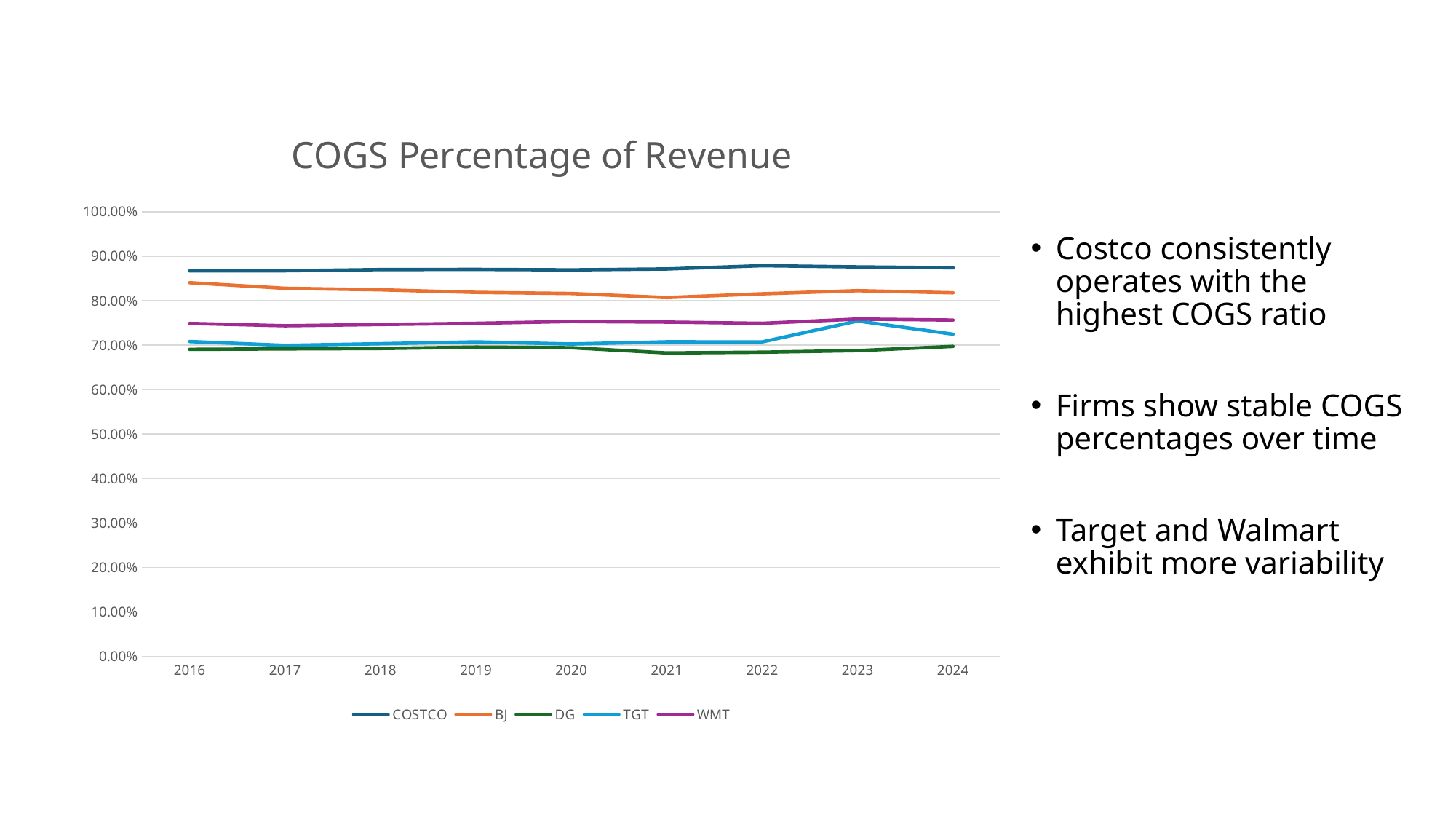
Which series has the lowest COGS percentage of revenue in 2021? DG How many series does the legend list? 5 Is the value for BJ in 2021 greater or less than 90.00%? less What is the title of the chart? COGS Percentage of Revenue How many years are shown along the x axis? 9 Which series has the highest COGS percentage of revenue across all years? COSTCO Does the BJ line rise or fall from 2016 to 2021? fall Which is larger in 2022, the value for COSTCO or the value for BJ? COSTCO Is the value for DG in 2021 greater or less than 70.00%? less Is the value for COSTCO in 2016 greater or less than 80.00%? greater Which is larger in 2023, the value for TGT or the value for DG? TGT What kind of chart is shown on the slide? line chart